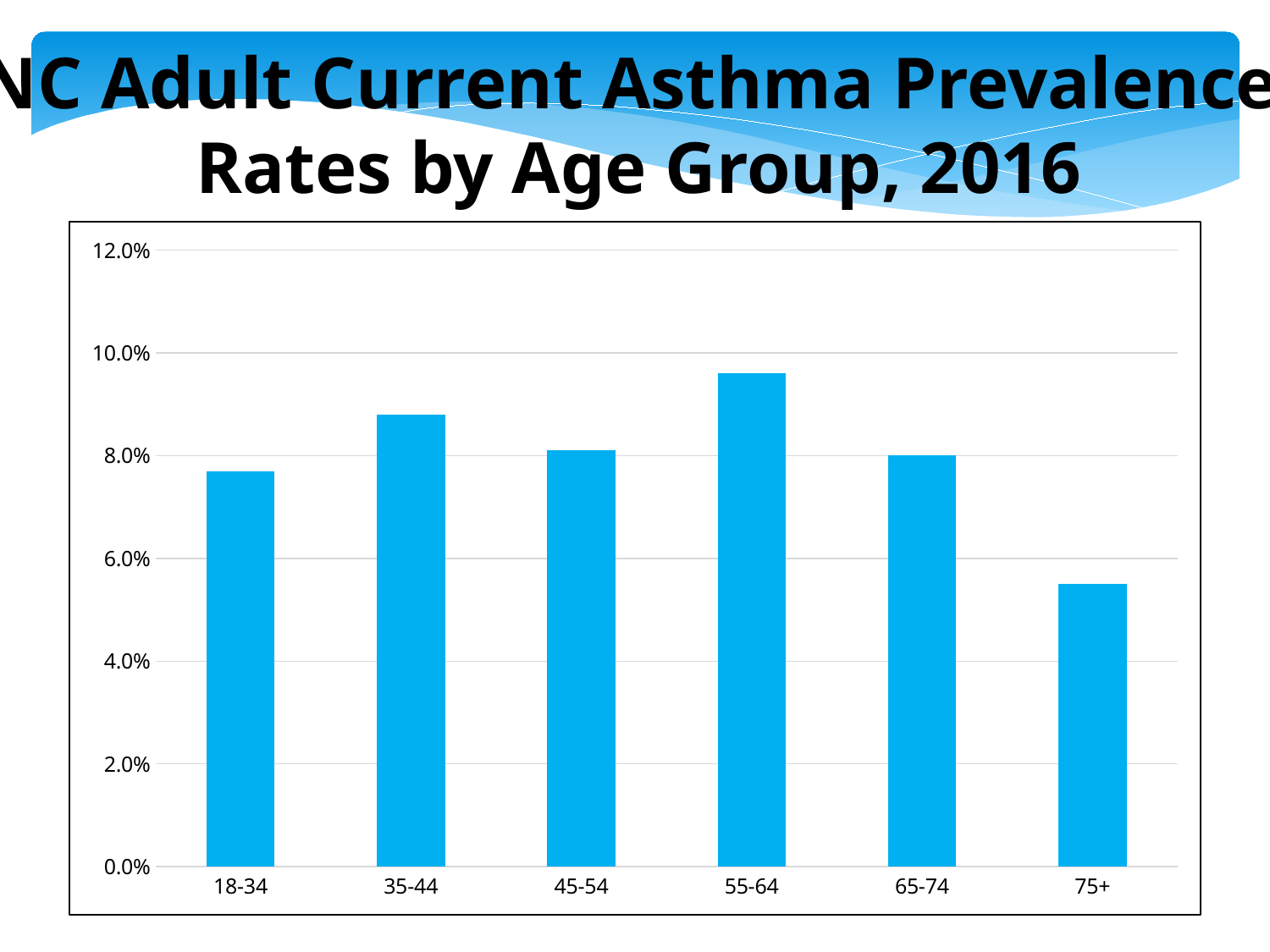
Is the value for the 75+ age group greater or less than 6.0%? less Do the values rise or fall from the 55-64 age group to the 75+ age group? fall Is the value for the 18-34 age group greater or less than 8.0%? less What is the title of the chart on the slide? NC Adult Current Asthma Prevalence Rates by Age Group, 2016 Which has the higher asthma prevalence rate, the 35-44 age group or the 18-34 age group? 35-44 Is the value for the 55-64 age group greater or less than 8.0%? greater Which age group has the lowest asthma prevalence rate? 75+ How many age groups are shown on the x axis? 6 What kind of chart is shown on the slide? bar chart Which age group has the highest asthma prevalence rate? 55-64